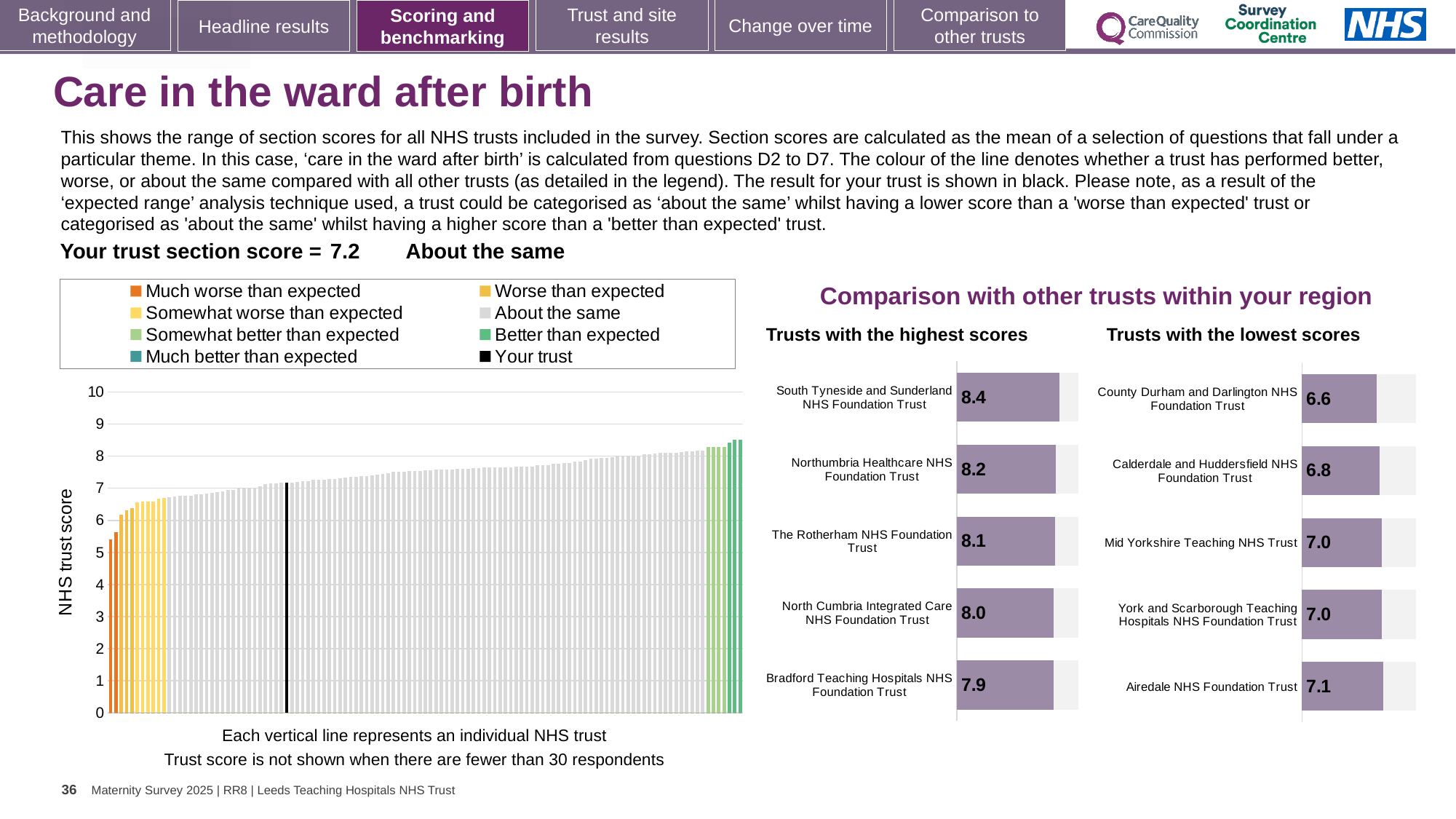
In the 'Trusts with the highest scores' chart, what is the difference between the scores of South Tyneside and Sunderland NHS Foundation Trust and Bradford Teaching Hospitals NHS Foundation Trust? 0.5 In the large chart on the left, do the trust scores rise or fall from left to right along the x axis? Rise In the 'Trusts with the lowest scores' chart, which trust has the lowest score? County Durham and Darlington NHS Foundation Trust In the 'Trusts with the highest scores' chart, what is the score for South Tyneside and Sunderland NHS Foundation Trust? 8.4 In the 'Trusts with the lowest scores' chart, which has the larger score: Calderdale and Huddersfield NHS Foundation Trust or Mid Yorkshire Teaching NHS Trust? Mid Yorkshire Teaching NHS Trust How many entries does the legend of the large chart on the left list? 8 In the 'Trusts with the highest scores' chart, which trust has the highest score? South Tyneside and Sunderland NHS Foundation Trust In the 'Trusts with the lowest scores' chart, how many trusts are listed? 5 In the 'Trusts with the lowest scores' chart, what is the score for County Durham and Darlington NHS Foundation Trust? 6.6 In the 'Trusts with the highest scores' chart, what is the score for Bradford Teaching Hospitals NHS Foundation Trust? 7.9 What kind of chart is the large chart on the left of the slide showing NHS trust scores? Bar chart In the 'Trusts with the lowest scores' chart, what is the difference between the scores of Airedale NHS Foundation Trust and County Durham and Darlington NHS Foundation Trust? 0.5